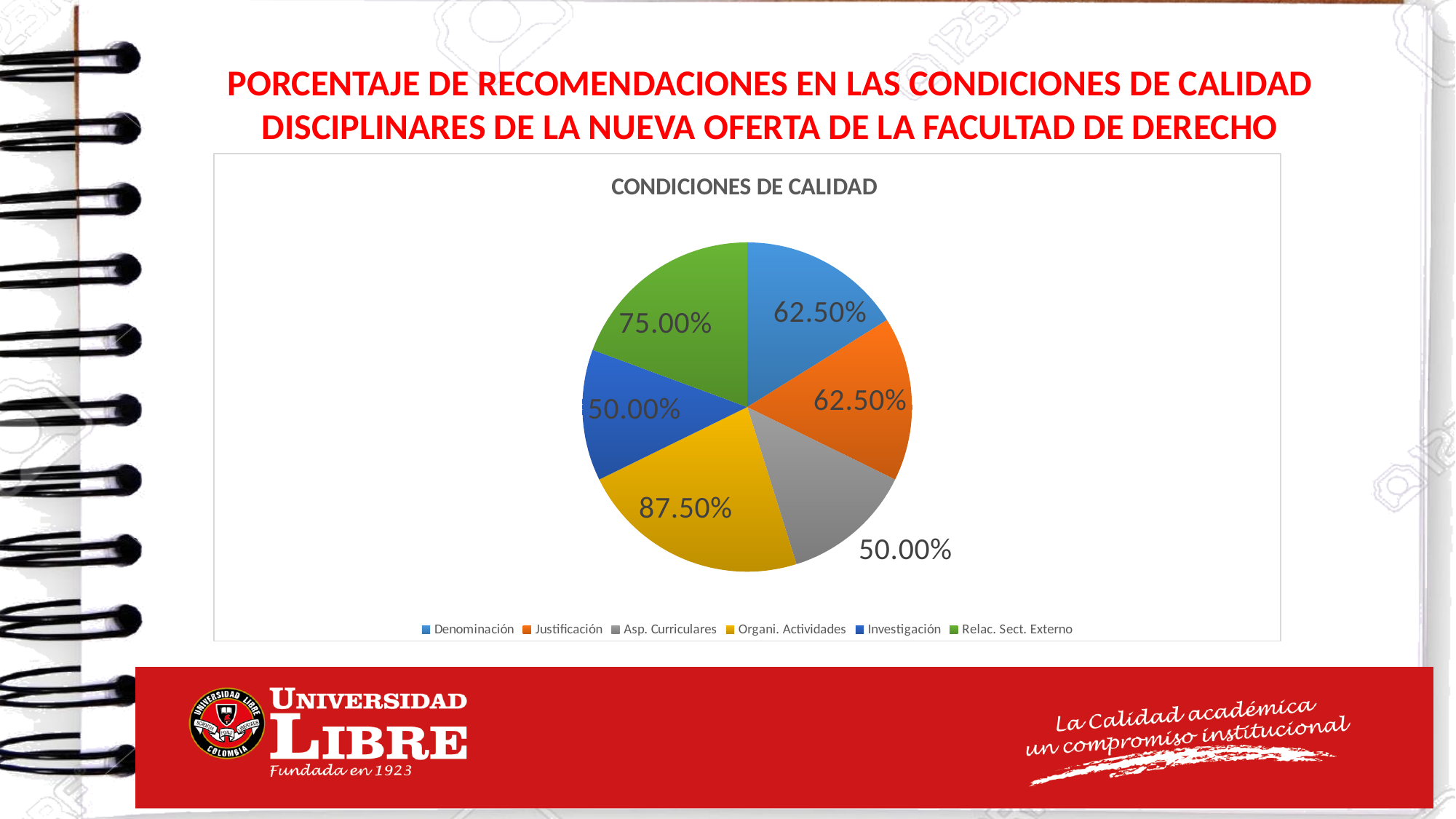
Which colour represents Justificación in the legend? orange How many categories does the pie chart have? 6 What is the value shown for Asp. Curriculares? 50.00% What is the title of the chart? CONDICIONES DE CALIDAD Which is larger, the value for Relac. Sect. Externo or the value for Denominación? Relac. Sect. Externo What is the value shown for Organi. Actividades? 87.50% Which category has the highest value? Organi. Actividades What kind of chart is shown on the slide? pie chart What is the difference between the value for Organi. Actividades and the value for Investigación? 37.50% What is the value shown for Denominación? 62.50% What is the value shown for Investigación? 50.00% What is the value shown for Relac. Sect. Externo? 75.00%